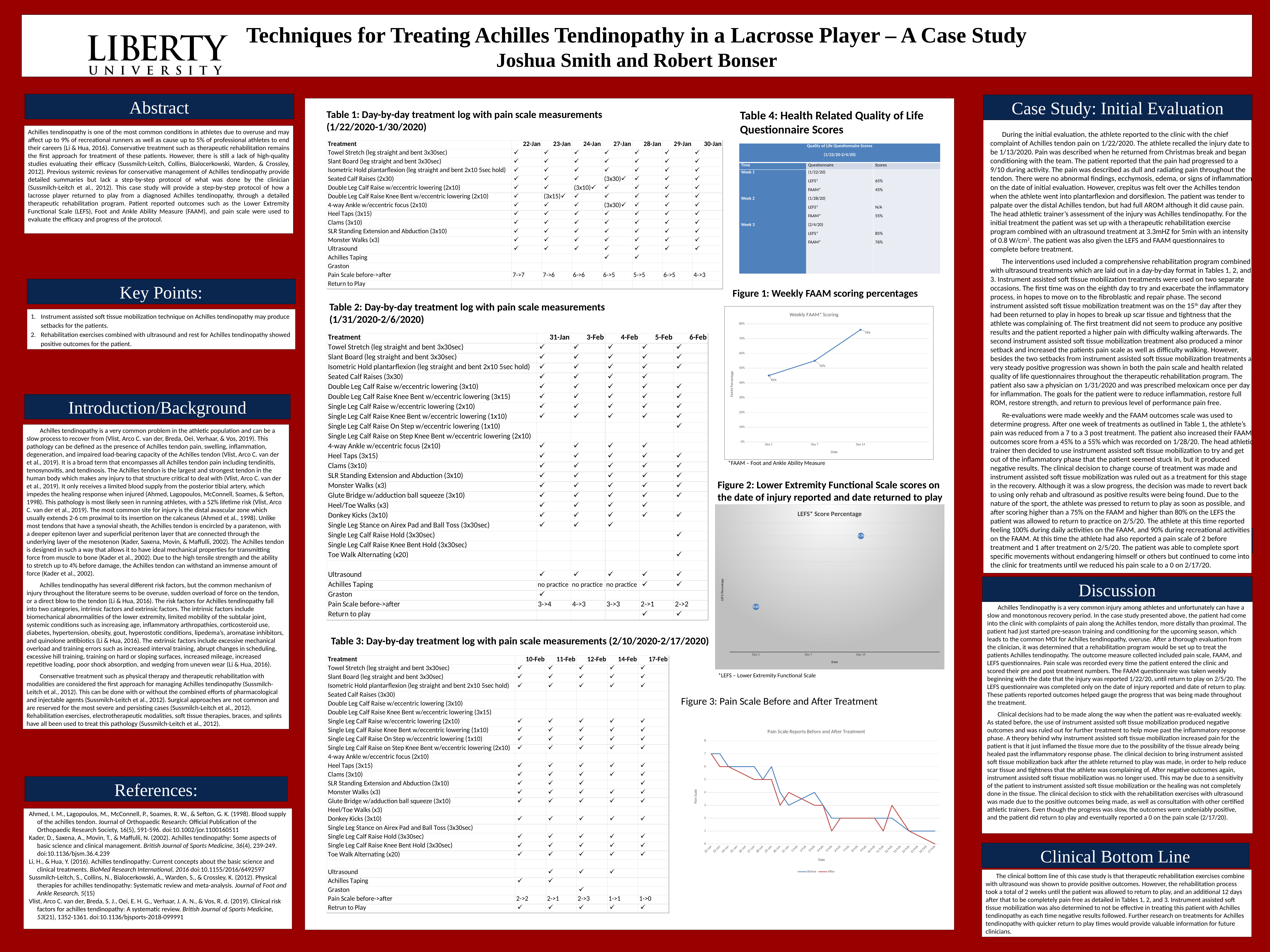
In Figure 1 (Weekly FAAM scoring percentages), which day has the lowest FAAM score? Day 1 In Figure 1 (Weekly FAAM scoring percentages), which day has the highest FAAM score? Day 14 In Figure 2 (LEFS Score Percentage), which is larger, the Day 1 value or the Day 14 value? Day 14 In Figure 1 (Weekly FAAM scoring percentages), what is the FAAM score on Day 14? 76% In Figure 2 (LEFS Score Percentage), how many data points are plotted? 2 In Figure 1 (Weekly FAAM scoring percentages), by how many percentage points does the score increase from Day 1 to Day 14? 31 In Figure 3 (Pain Scale Reports Before and After Treatment), what are the two series named in the legend? Before and After In Figure 1 (Weekly FAAM scoring percentages), what is the FAAM score on Day 1? 45% In Figure 1 (Weekly FAAM scoring percentages), do the values rise or fall from Day 1 to Day 14? rise In Figure 1 (Weekly FAAM scoring percentages), how many data points are plotted? 3 In Figure 1 (Weekly FAAM scoring percentages), what kind of chart is shown? line chart In Figure 3 (Pain Scale Reports Before and After Treatment), how many series does the legend list? 2